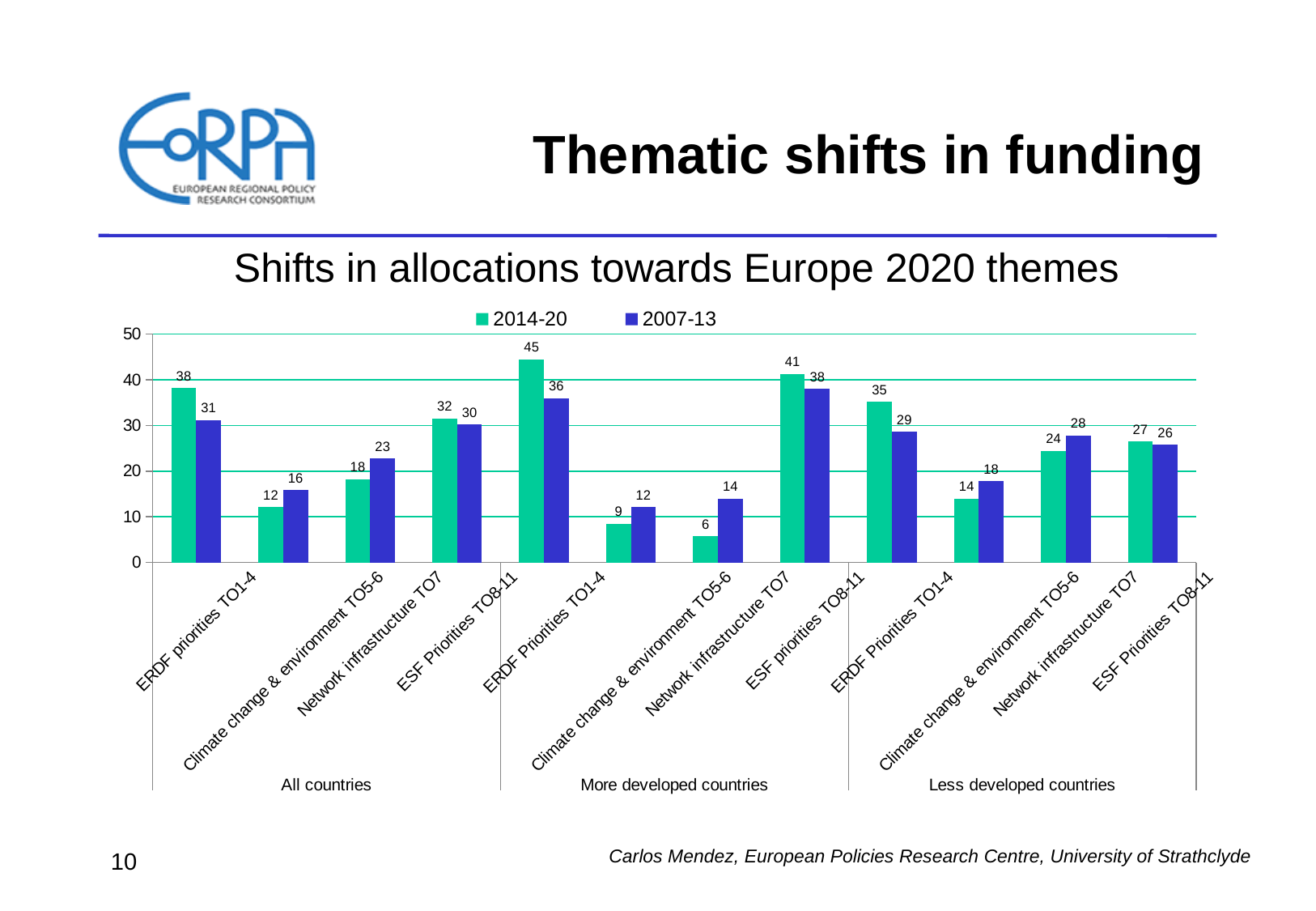
What is the 2007-13 value for Network infrastructure TO7 under More developed countries? 14 How many country groups are shown along the x axis? 3 Is the 2014-20 value for ESF priorities TO8-11 under More developed countries greater or less than 40? greater What is the 2014-20 value for ERDF priorities TO1-4 under All countries? 38 For Network infrastructure TO7 under All countries, which is larger: the 2014-20 value or the 2007-13 value? 2007-13 What kind of chart is shown on the slide? Bar chart What is the 2014-20 value for Climate change & environment TO5-6 under Less developed countries? 14 Which category has the lowest 2014-20 value across the whole chart? Network infrastructure TO7 (More developed countries) What is the difference between the 2014-20 and 2007-13 values for ERDF Priorities TO1-4 under More developed countries? 9 How many series does the legend list? 2 What is the title of the chart? Shifts in allocations towards Europe 2020 themes Which category has the highest 2014-20 value across the whole chart? ERDF Priorities TO1-4 (More developed countries)